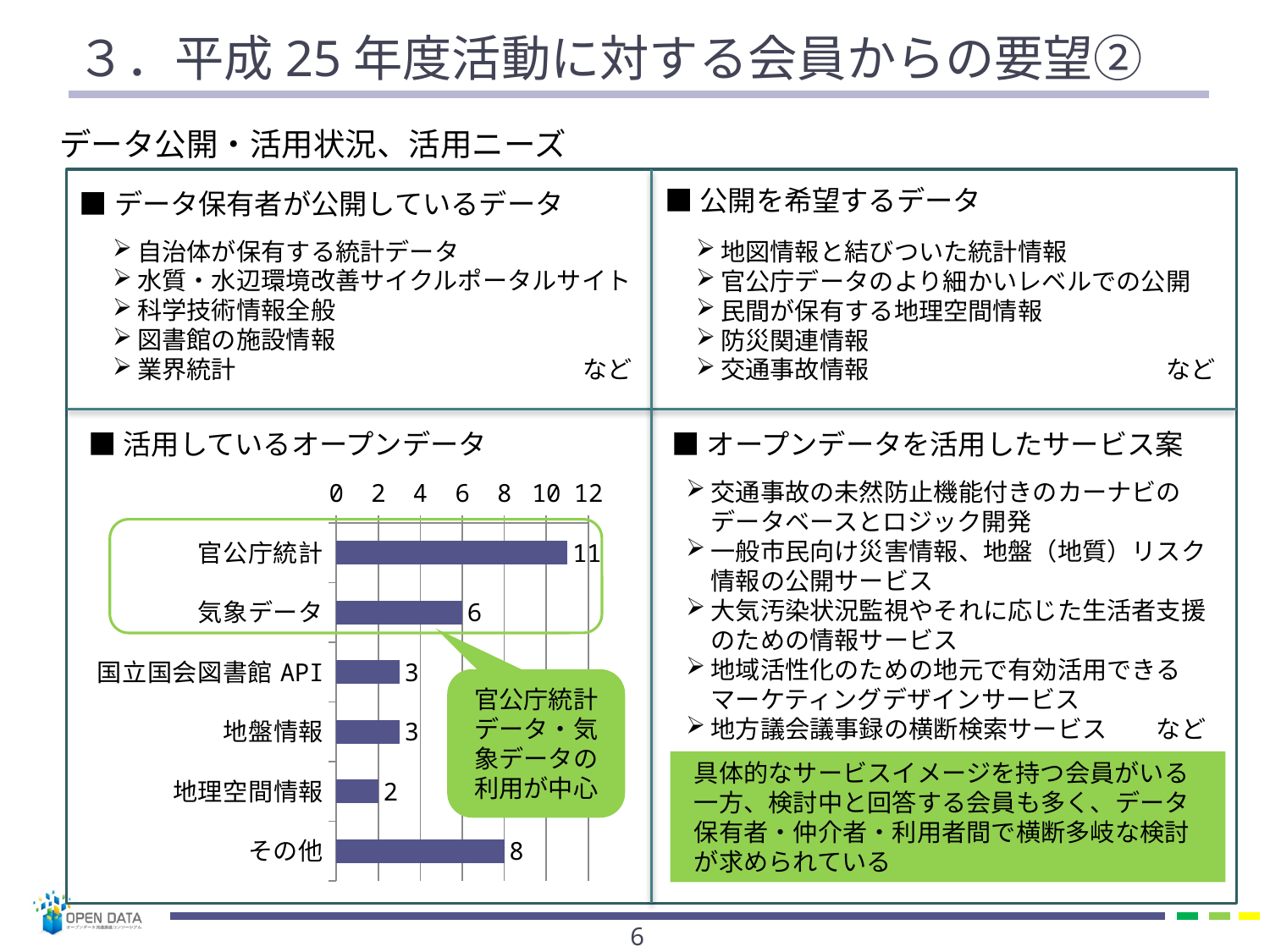
Is the value for 官公庁統計 greater or less than 10? greater Which category has the highest value in the bar chart? 官公庁統計 What is the value for 気象データ in the bar chart? 6 What is the highest tick value shown on the chart's axis? 12 What is the value for 地理空間情報 in the bar chart? 2 What kind of chart is shown on the slide? bar chart Which is larger, the value for その他 or the value for 気象データ? その他 What is the value for 官公庁統計 in the bar chart? 11 Which category has the lowest value in the bar chart? 地理空間情報 What is the value for その他 in the bar chart? 8 What is the difference between the values for 官公庁統計 and 気象データ? 5 How many categories are shown in the bar chart? 6